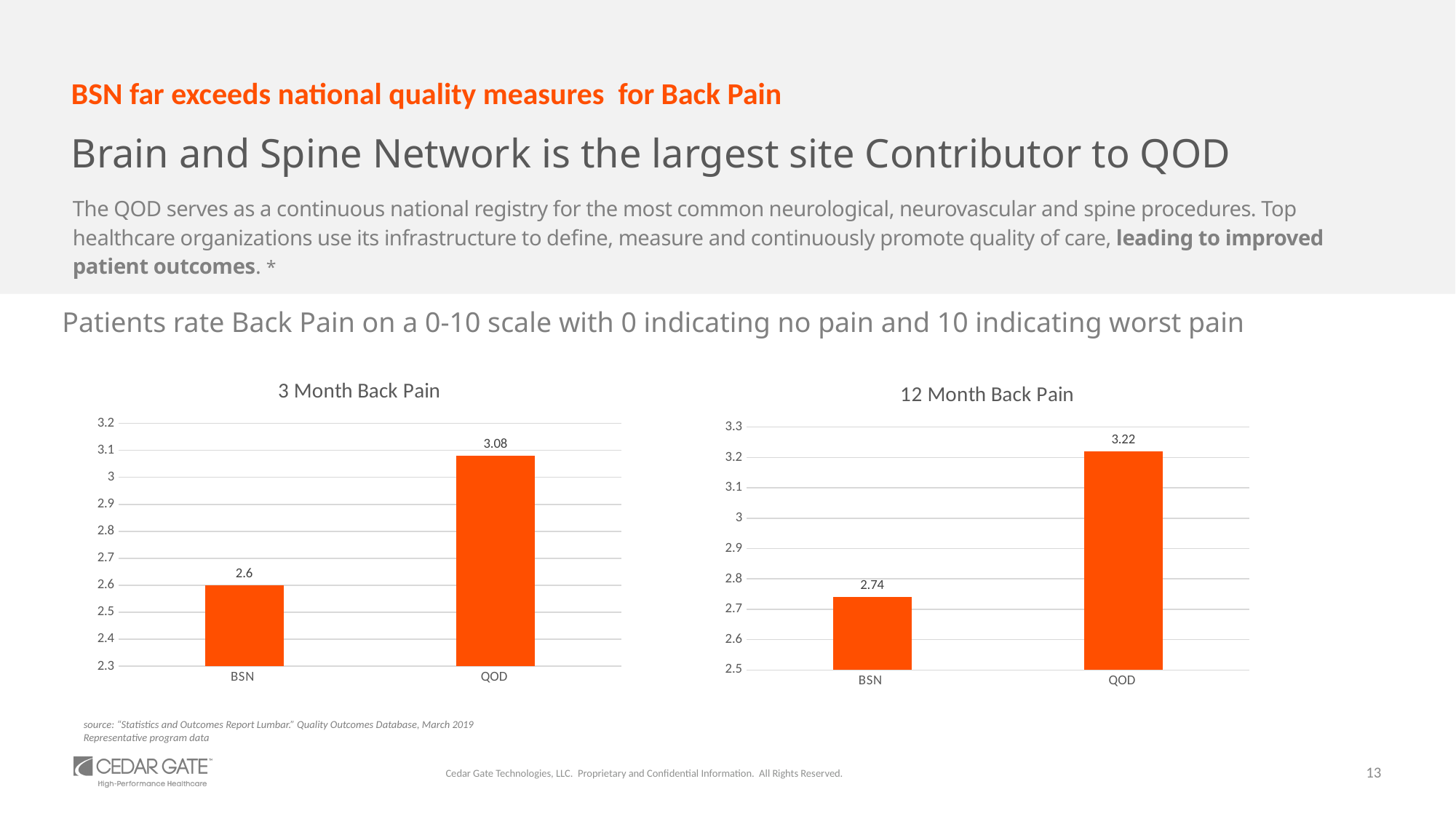
In the 12 Month Back Pain chart, what is the difference between the QOD and BSN values? 0.48 How many categories are shown in the 12 Month Back Pain chart? 2 In the 3 Month Back Pain chart, what is the difference between the QOD and BSN values? 0.48 In the 12 Month Back Pain chart, what is the value for BSN? 2.74 In the 12 Month Back Pain chart, what is the value for QOD? 3.22 In the 12 Month Back Pain chart, which category has the lowest value? BSN In the 3 Month Back Pain chart, what is the value for BSN? 2.6 In the 12 Month Back Pain chart, which is larger, the value for BSN or the value for QOD? QOD In the 3 Month Back Pain chart, what is the value for QOD? 3.08 What kind of chart is the 3 Month Back Pain chart? Bar chart In the 3 Month Back Pain chart, is the value for QOD greater or less than 3? greater In the 3 Month Back Pain chart, which category has the highest value? QOD